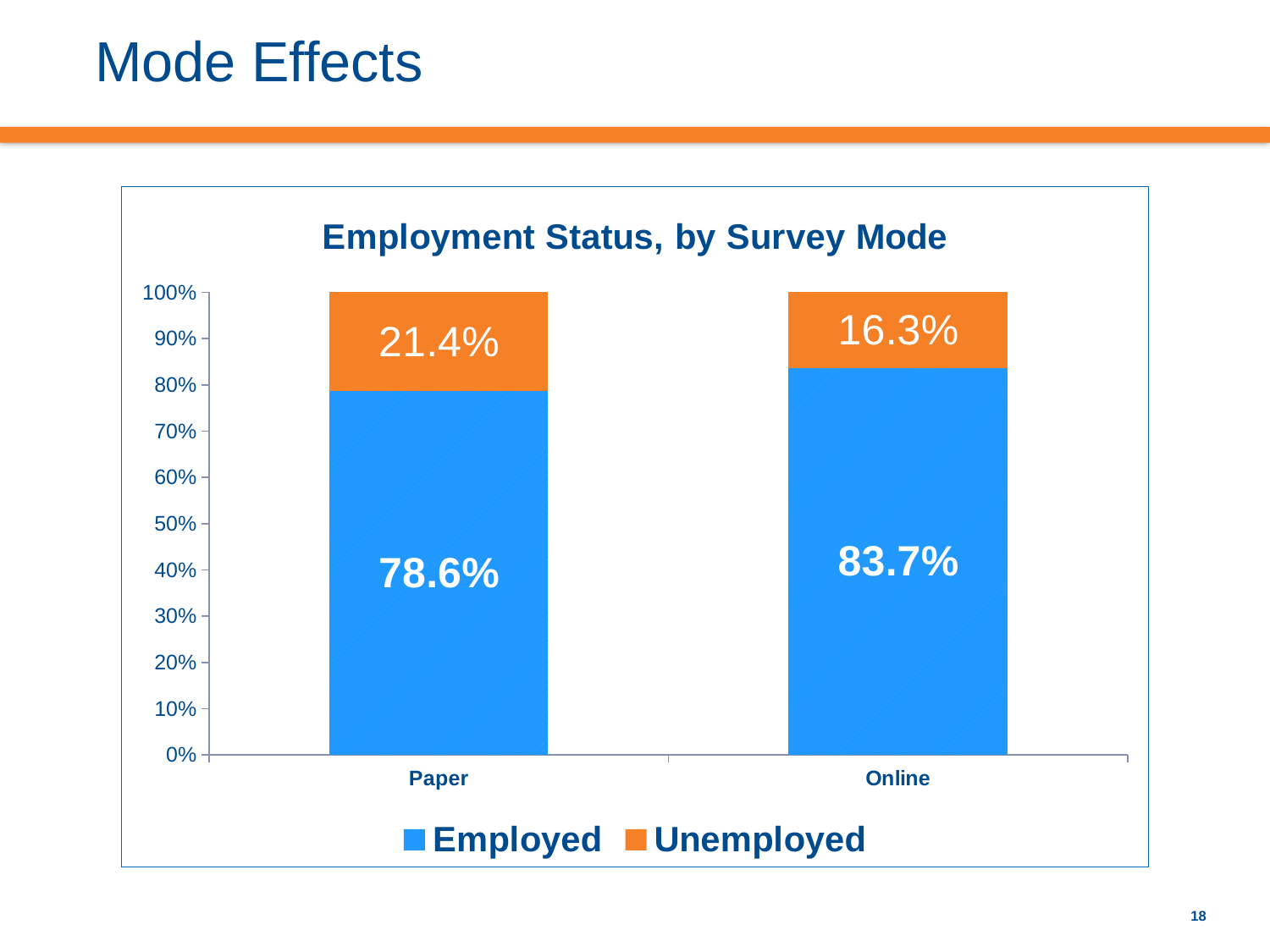
Which survey mode has the higher Employed share? Online What kind of chart is shown? stacked bar chart What is the Employed value for Paper? 78.6% How many series does the legend list? 2 What is the Unemployed value for Online? 16.3% What is the difference between the Employed values for Online and Paper? 5.1% What is the Unemployed value for Paper? 21.4% How many survey modes are shown on the x axis? 2 What is the title of the chart? Employment Status, by Survey Mode Which survey mode has the lower Unemployed share? Online What is the Employed value for Online? 83.7% Is the Unemployed value for Paper larger or smaller than the Unemployed value for Online? larger